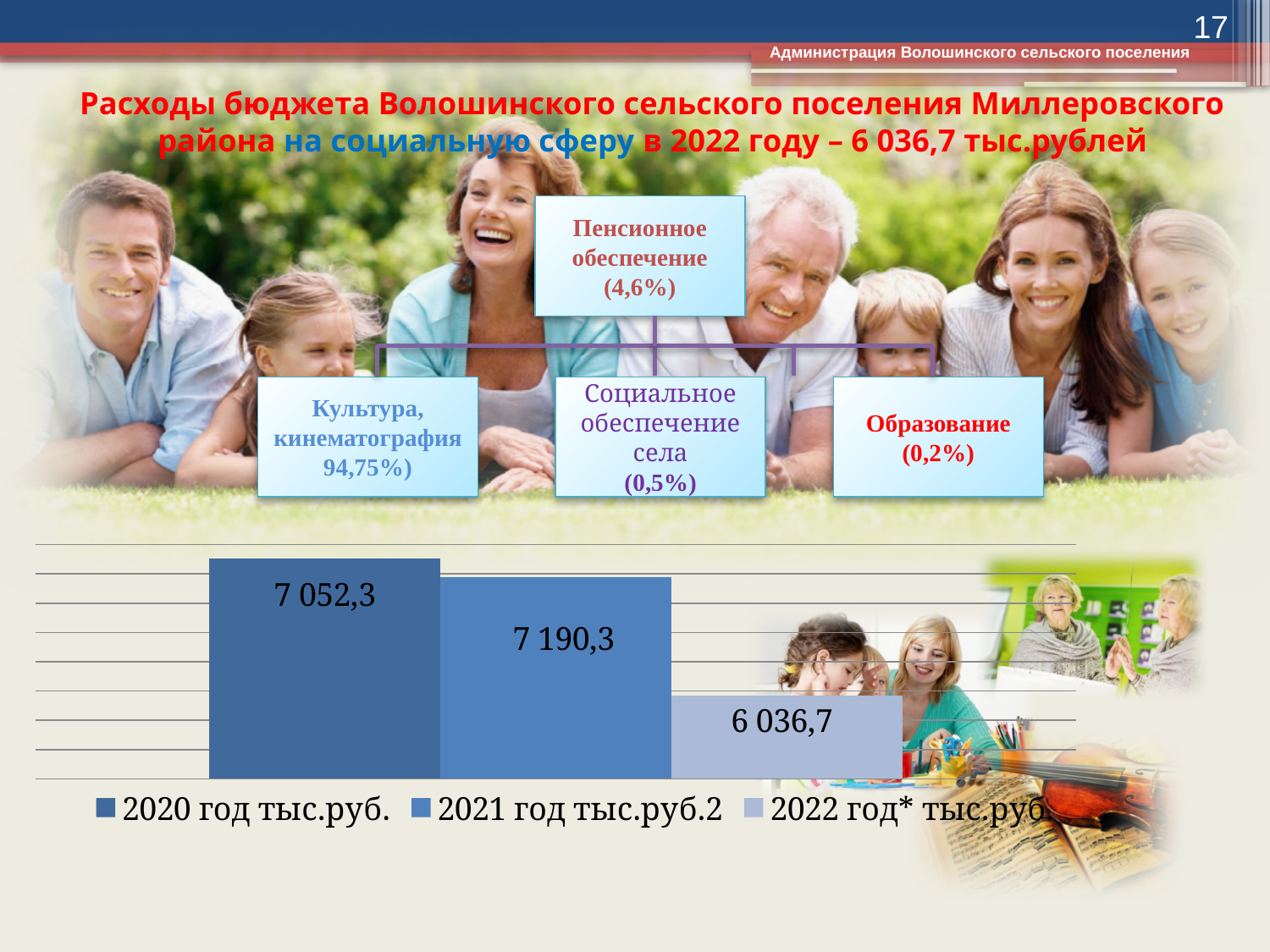
Which year has the highest value in the bar chart? 2021 год тыс.руб.2 What is the difference between the 2021 and 2022 values in the bar chart? 1 153,6 Which is larger in the bar chart, the value for 2020 or the value for 2022? 2020 What is the value shown for 2021 год тыс.руб.2 in the bar chart? 7 190,3 What type of chart is shown at the bottom of the slide? bar chart Which year has the lowest value in the bar chart? 2022 год* тыс.руб What is the value shown for 2022 год* тыс.руб in the bar chart? 6 036,7 What is the difference between the 2021 and 2020 values in the bar chart? 138 How many bars are plotted in the bar chart? 3 Do the values in the bar chart rise or fall from 2021 to 2022? fall What is the value shown for 2020 год тыс.руб. in the bar chart? 7 052,3 How many series does the legend of the bar chart list? 3